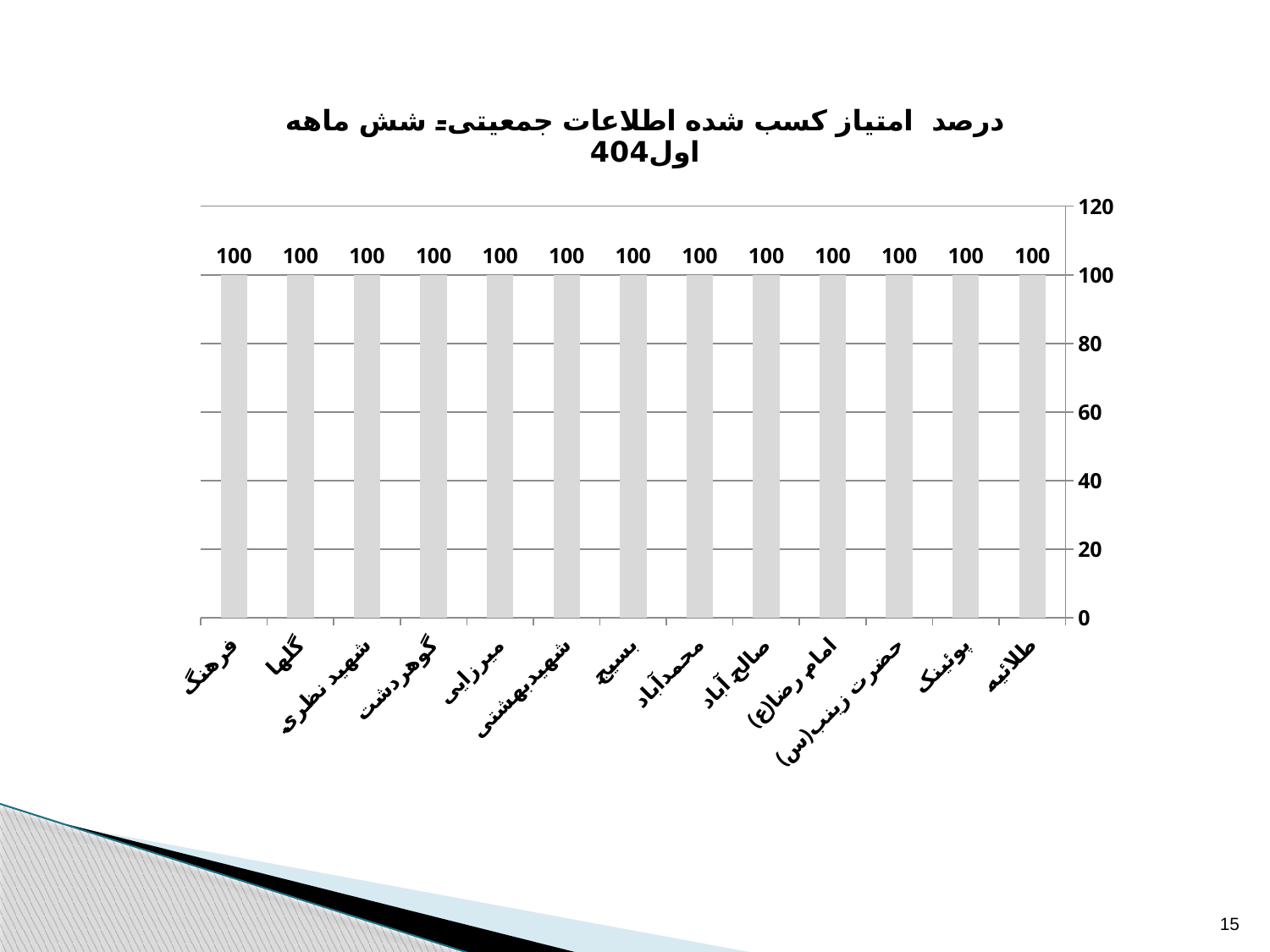
What is the value for فرهنگ? 100 What is the highest tick value shown on the vertical axis? 120 Do the values rise, fall, or stay the same across the categories? stay the same What is the value for گوهردشت? 100 What is the value for طلائیه? 100 What is the value for بسیج? 100 What is the title of the chart? درصد امتیاز کسب شده اطلاعات جمعیتی- شش ماهه اول404 What is the value for حضرت زینب(س)? 100 How many categories are shown on the x axis? 13 What is the difference between the values for گلها and بوئینک? 0 Is the value for صالح آباد greater or less than 80? greater What kind of chart is shown on the slide? bar chart